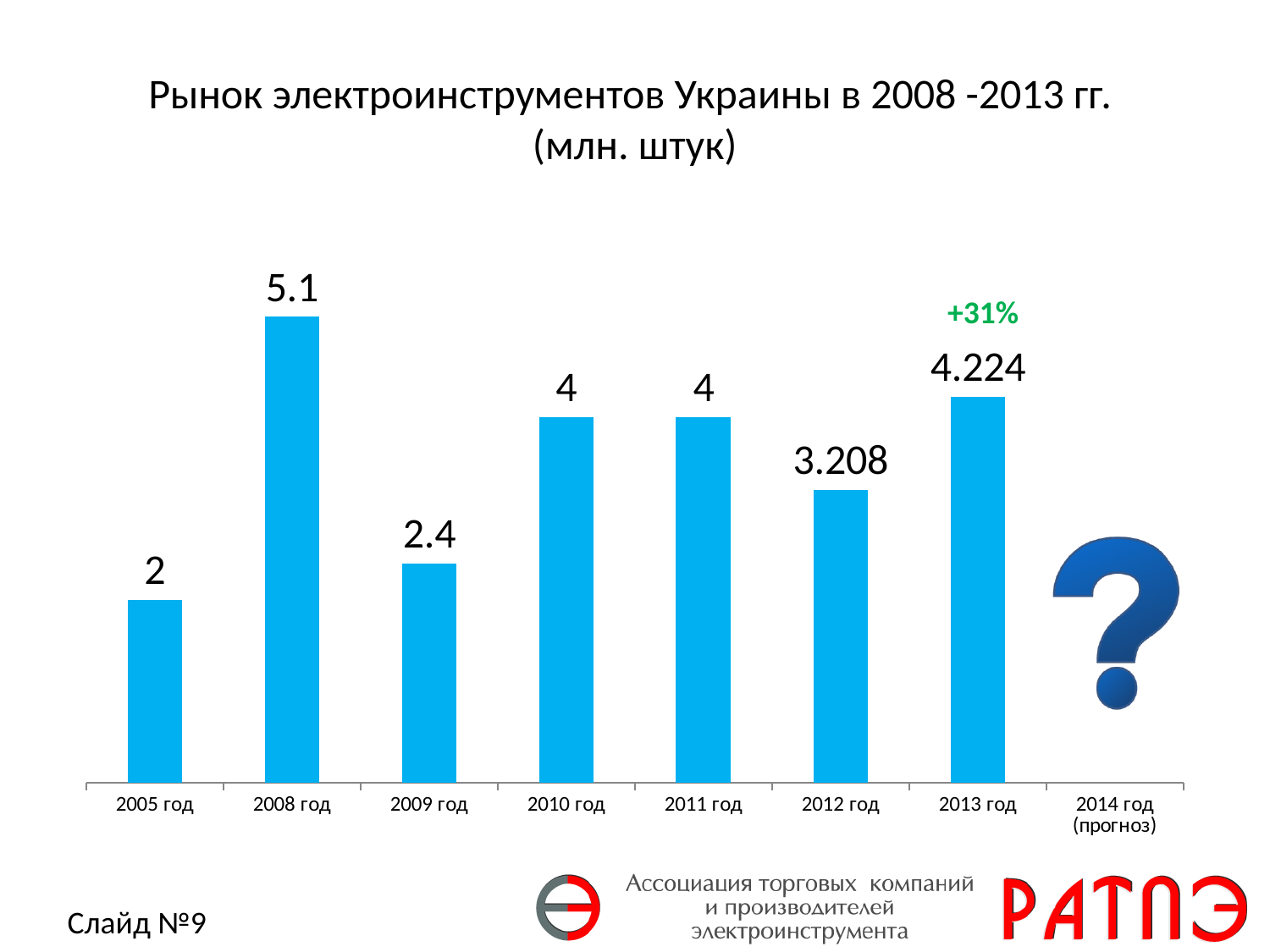
Which year has the highest value? 2008 год What is the value for 2005 год? 2 What kind of chart is shown on the slide? Bar chart What percentage change is annotated above the 2013 год bar? +31% What is the difference between the values for 2008 год and 2005 год? 3.1 Which year has the lowest value? 2005 год Which is larger, the value for 2009 год or the value for 2012 год? 2012 год What is the value for 2013 год? 4.224 What is the value for 2008 год? 5.1 How many bars with values are plotted on the chart? 7 What is the difference between the values for 2013 год and 2012 год? 1.016 What is the value for 2012 год? 3.208